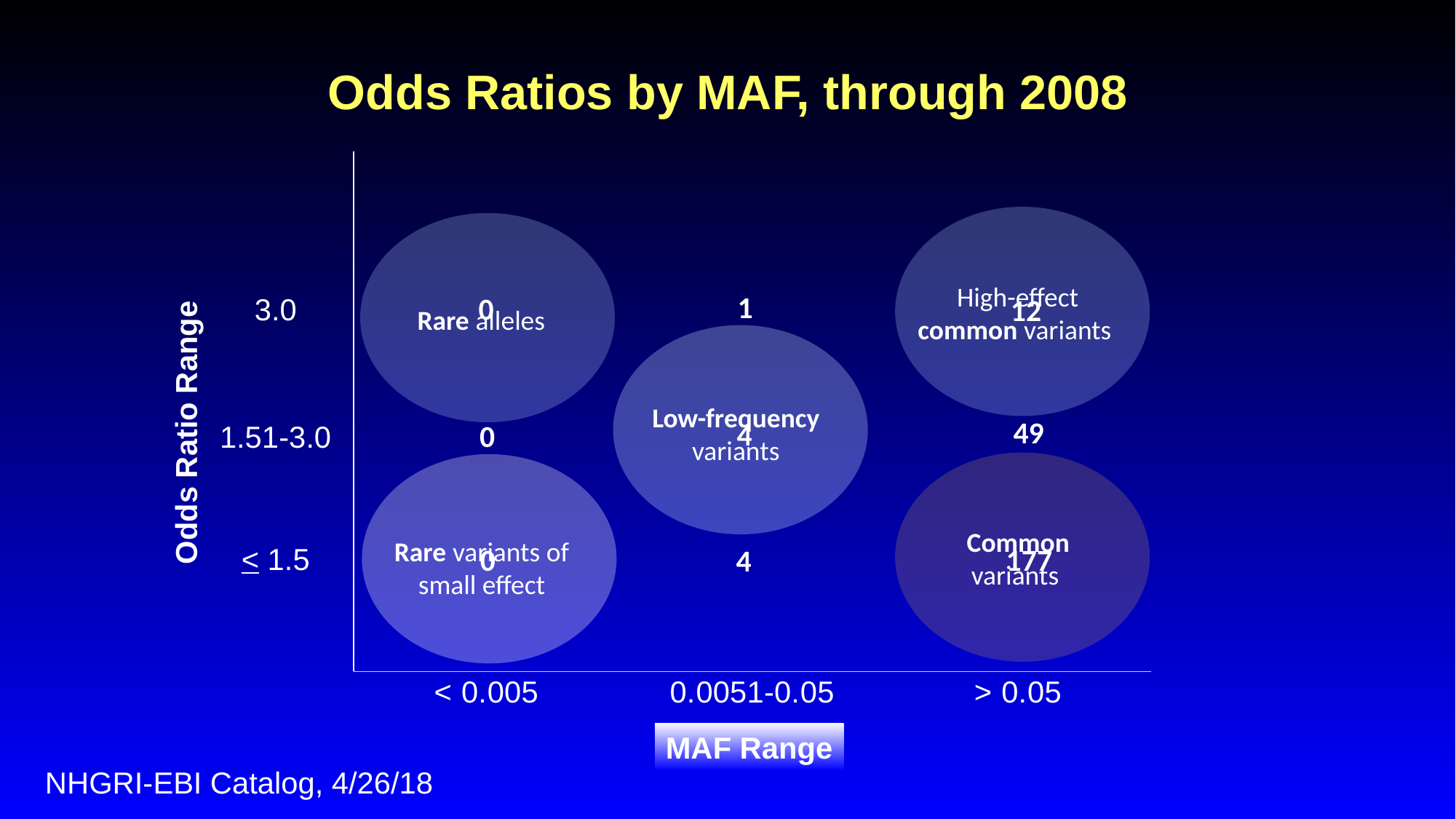
What is the title of the chart? Odds Ratios by MAF, through 2008 What is the count for MAF range < 0.005 and odds ratio range ≤ 1.5? 0 What is the count for MAF range 0.0051-0.05 and odds ratio range 1.51-3.0? 4 What is the count for MAF range > 0.05 and odds ratio range 1.51-3.0? 49 What is the difference between the counts for MAF > 0.05 at odds ratio ≤ 1.5 and at odds ratio 1.51-3.0? 128 What is the count for MAF range 0.0051-0.05 and odds ratio range 3.0? 1 What is the count for MAF range > 0.05 and odds ratio range 3.0? 12 What is the total count across all three odds ratio ranges for MAF > 0.05? 238 Which cell of the grid has the highest count? MAF > 0.05, odds ratio ≤ 1.5 (177) Which is larger: the count for MAF > 0.05 at odds ratio 3.0, or the count for MAF 0.0051-0.05 at odds ratio 1.51-3.0? MAF > 0.05 at odds ratio 3.0 (12) What is the count for MAF range > 0.05 and odds ratio range ≤ 1.5? 177 How many MAF range categories are shown on the x axis? 3